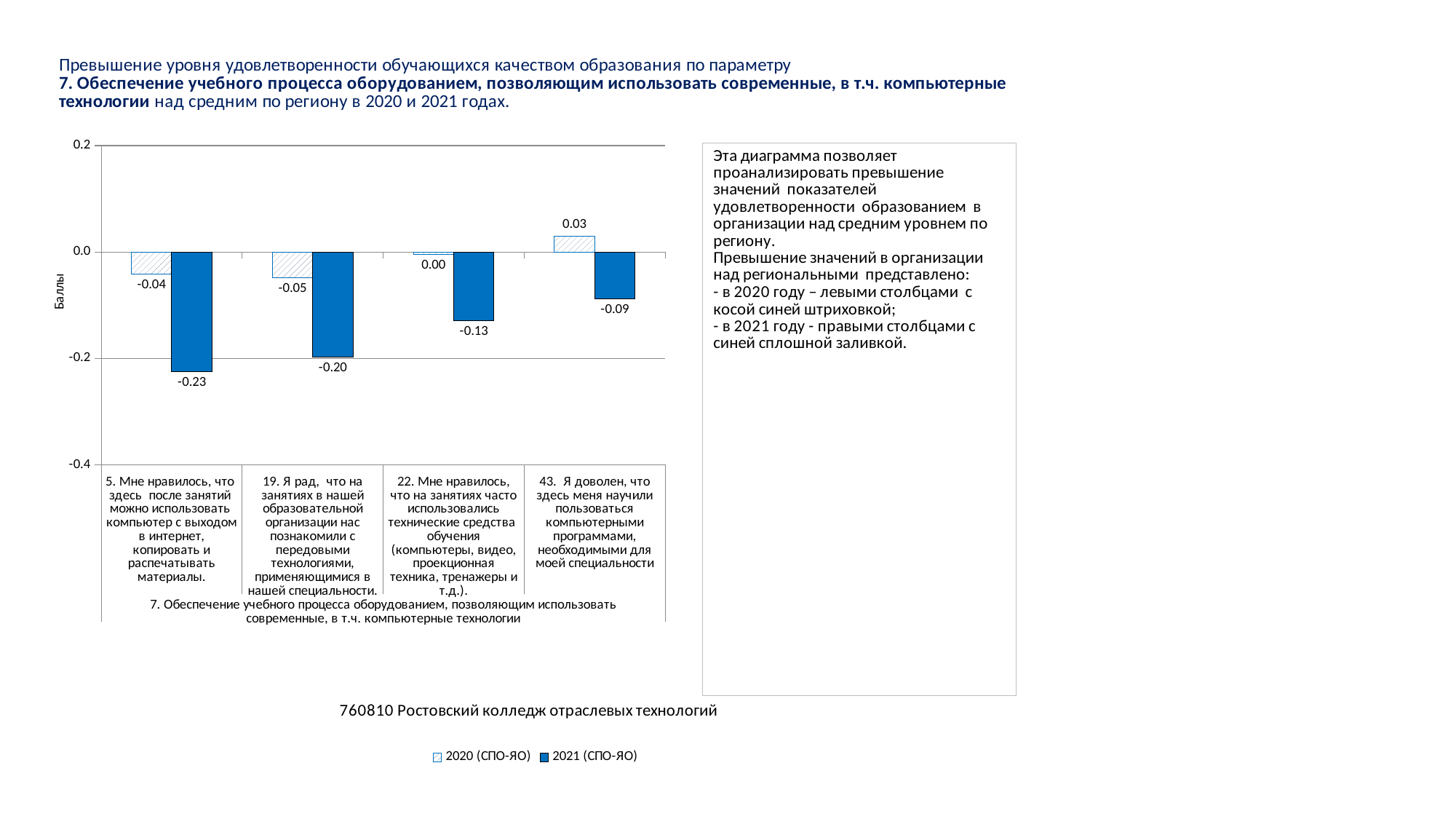
Which item has the lowest 2021 (СПО-ЯО) value? 5. Мне нравилось, что здесь после занятий можно использовать компьютер с выходом в интернет, копировать и распечатывать материалы. What is the 2021 (СПО-ЯО) value for item 5 ("Мне нравилось, что здесь после занятий можно использовать компьютер...")? -0.23 Which item has the highest 2020 (СПО-ЯО) value? 43. Я доволен, что здесь меня научили пользоваться компьютерными программами, необходимыми для моей специальности What is the 2020 (СПО-ЯО) value for item 43 ("Я доволен, что здесь меня научили пользоваться компьютерными программами...")? 0.03 How many items (categories) are shown on the x axis? 4 What is the 2020 (СПО-ЯО) value for item 19 ("Я рад, что на занятиях в нашей образовательной организации нас познакомили с передовыми технологиями...")? -0.05 For item 43, which is larger: the 2020 (СПО-ЯО) value or the 2021 (СПО-ЯО) value? 2020 (СПО-ЯО) What is the label of the vertical axis? Баллы What is the 2021 (СПО-ЯО) value for item 22 ("Мне нравилось, что на занятиях часто использовались технические средства обучения...")? -0.13 What kind of chart is shown on the slide? Bar chart What is the difference between the 2020 and 2021 values for item 19? 0.15 How many series does the legend list? 2